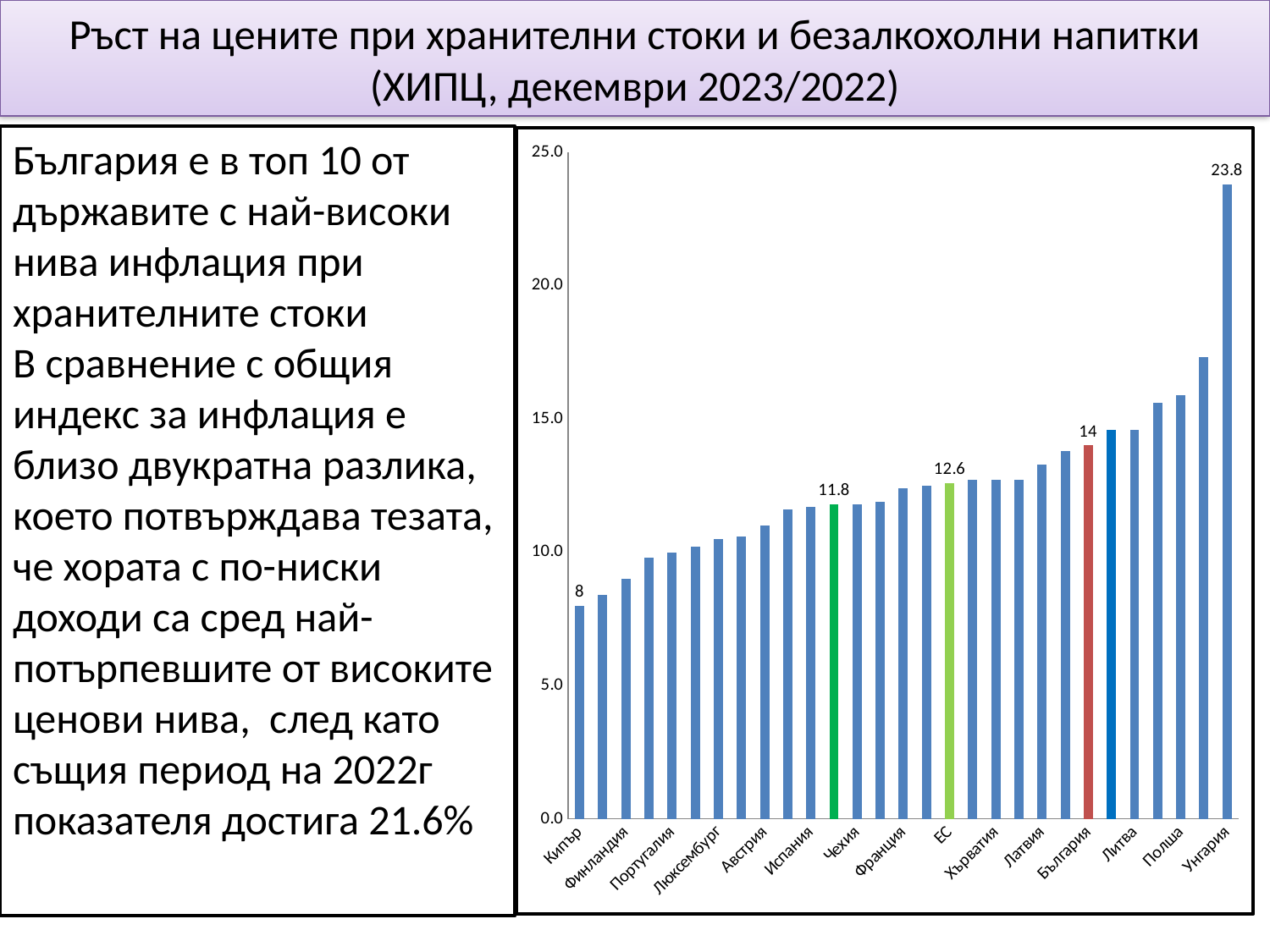
Is the value for Финландия greater or less than 10.0? less What is the value for Чехия? 11.8 What is the value for Унгария? 23.8 What is the value for ЕС? 12.6 Which category has the highest value? Унгария Which category has the lowest value? Кипър What is the value for Кипър? 8 What is the difference between the values for Унгария and България? 9.8 What is the difference between the values for България and ЕС? 1.4 Which is larger, the value for България or the value for ЕС? България What kind of chart is shown on the slide? bar chart What is the value for България? 14